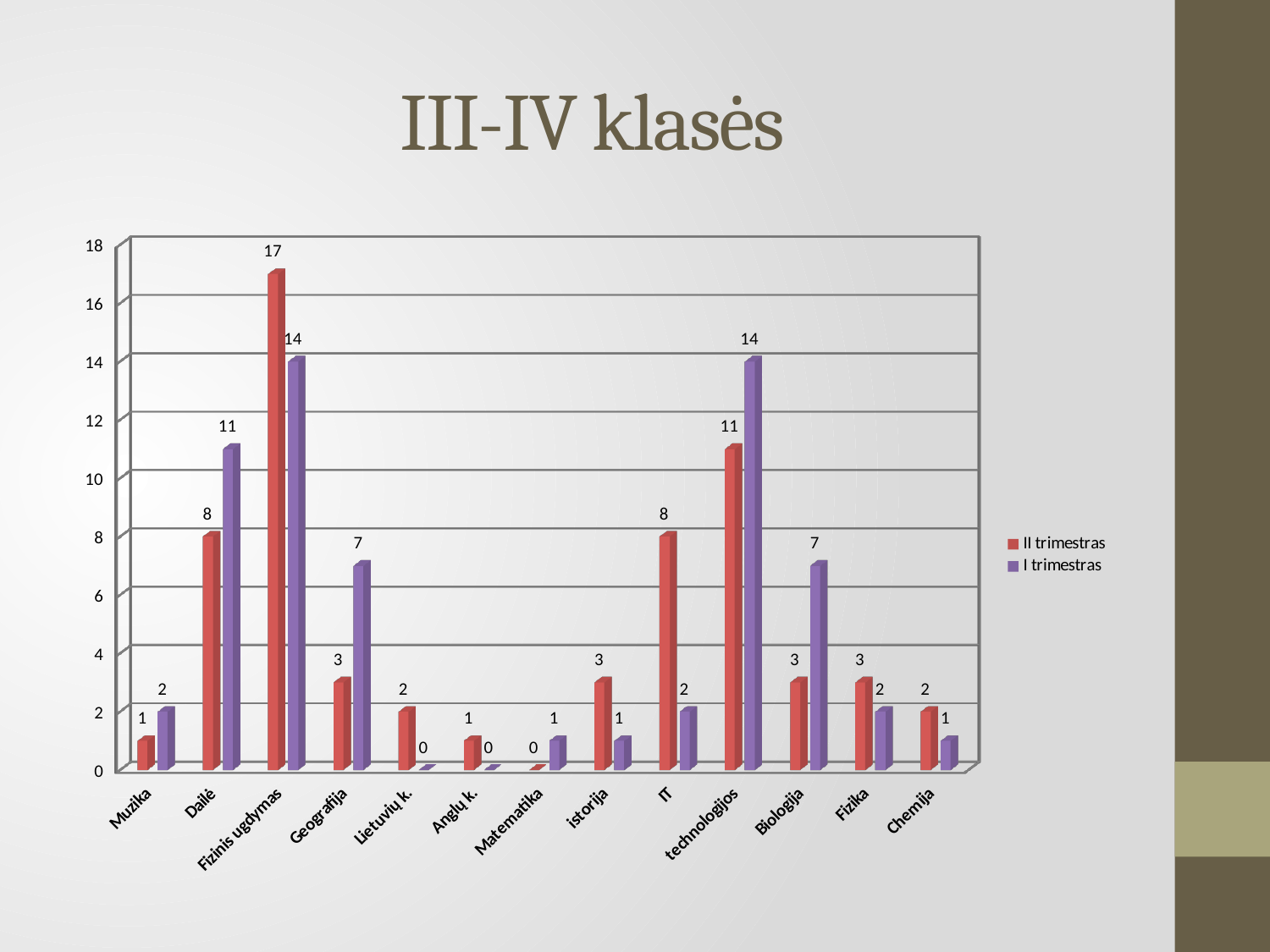
How many categories are shown on the x axis? 13 Which colour represents the I trimestras series? Purple What is the difference between the I trimestras and II trimestras values for Dailė? 3 What is the value for IT in the II trimestras series? 8 What kind of chart is shown on the slide? Bar chart Which category has the highest value in the II trimestras series? Fizinis ugdymas What is the value for Geografija in the I trimestras series? 7 What is the value for Fizinis ugdymas in the II trimestras series? 17 What is the title of the slide? III-IV klasės Which category has the lowest value in the II trimestras series? Matematika How many series does the legend list? 2 Which is larger for technologijos: the II trimestras value or the I trimestras value? I trimestras